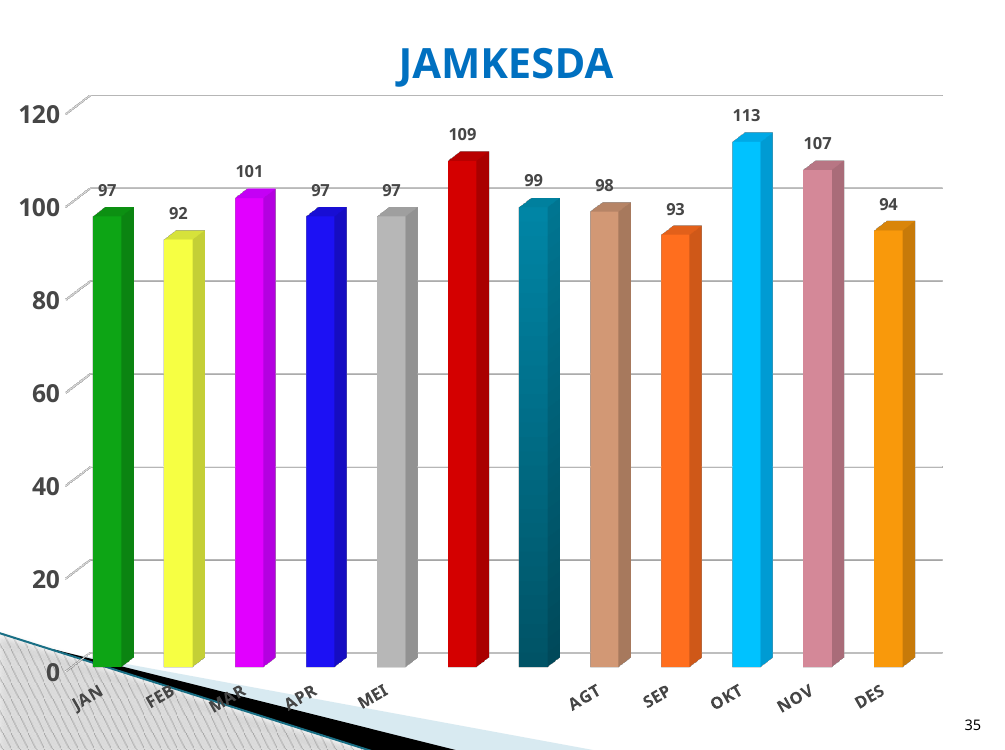
Is the value for NOV greater or less than 100? greater What is the value for NOV? 107 What type of chart is shown on the slide? bar chart Which month has the lowest value? FEB How many bars are shown in the chart? 12 Which month has the highest value? OKT What is the value for AGT? 98 What is the value for FEB? 92 What is the value for OKT? 113 Which is larger, the value for MAR or the value for APR? MAR What is the difference between the values for MAR and SEP? 8 What is the difference between the values for OKT and NOV? 6